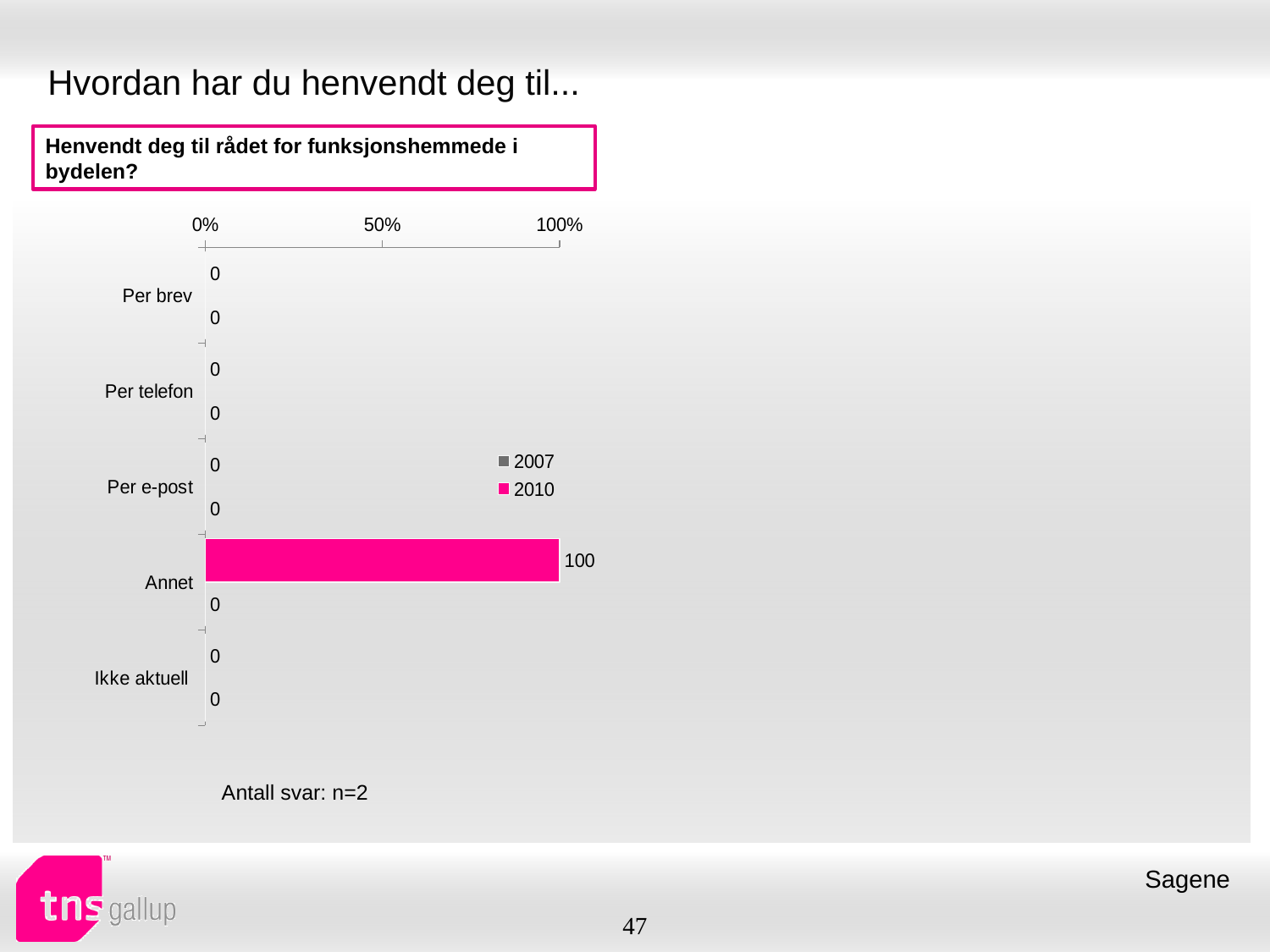
What is the value for Annet in the 2010 series? 100 What is the value for Ikke aktuell in the 2010 series? 0 Which category has the highest value in the 2010 series? Annet What is the value for Per telefon in the 2007 series? 0 What kind of chart is shown on the slide? Bar chart Which is larger for Annet: the 2010 value or the 2007 value? 2010 What is the title of the chart? Henvendt deg til rådet for funksjonshemmede i bydelen? How many series does the legend list? 2 What is the difference between the 2010 and 2007 values for Annet? 100 How many categories are shown on the chart? 5 What is the value for Per brev in the 2010 series? 0 Which colour represents the 2010 series in the legend? Pink